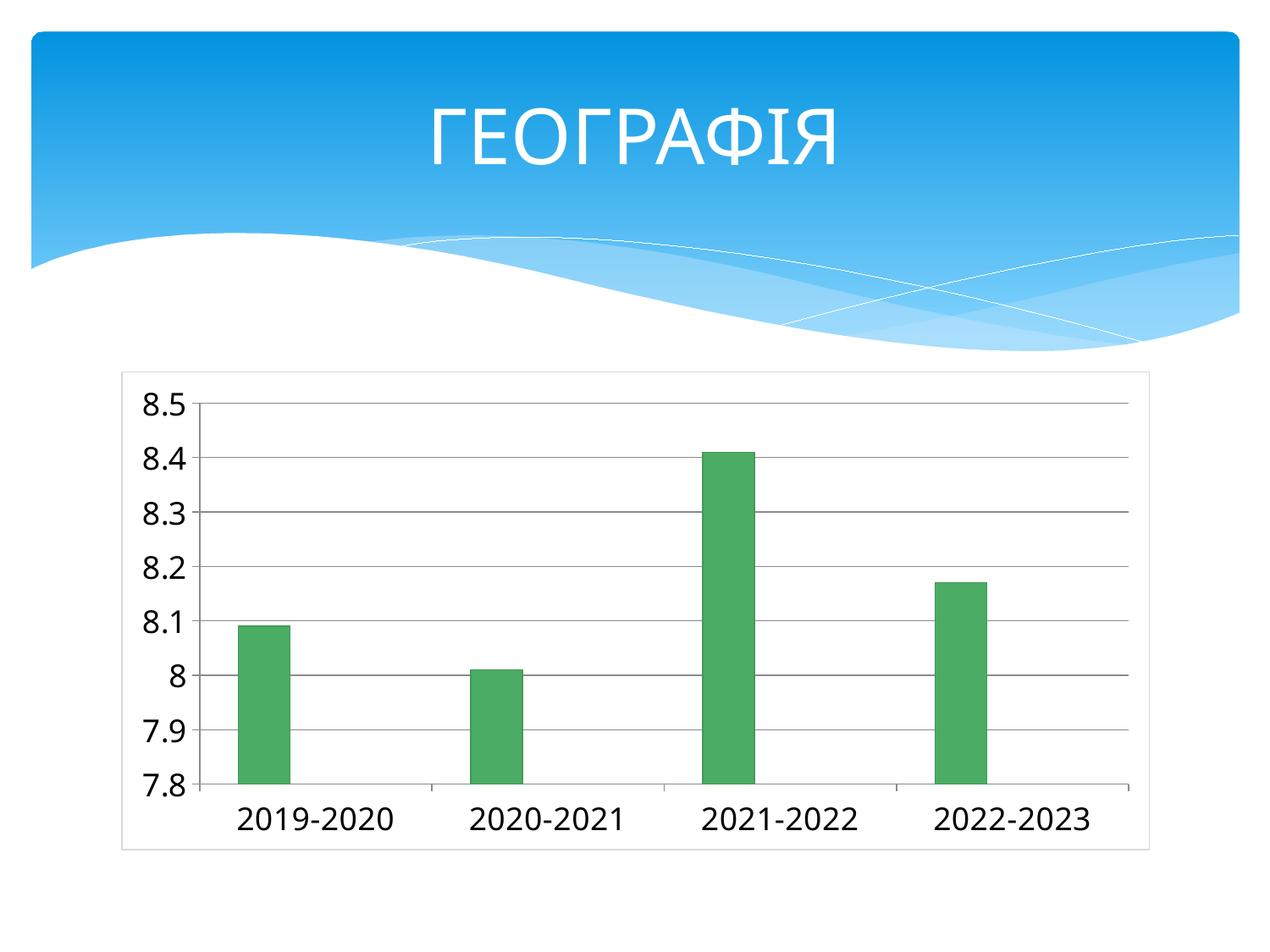
Which academic year has the lowest bar in the chart? 2020-2021 What is the title of the slide containing the chart? ГЕОГРАФІЯ Is the value for 2021-2022 greater or less than 8.3? greater Is the value for 2019-2020 greater or less than 8? greater Which is larger, the value for 2019-2020 or the value for 2022-2023? 2022-2023 Is the value for 2020-2021 greater or less than 8.1? less Does the value rise or fall from 2021-2022 to 2022-2023? fall What colour are the bars in the chart? green How many academic years are shown on the x axis of the chart? 4 What kind of chart is shown on the slide? bar chart Which academic year has the highest bar in the chart? 2021-2022